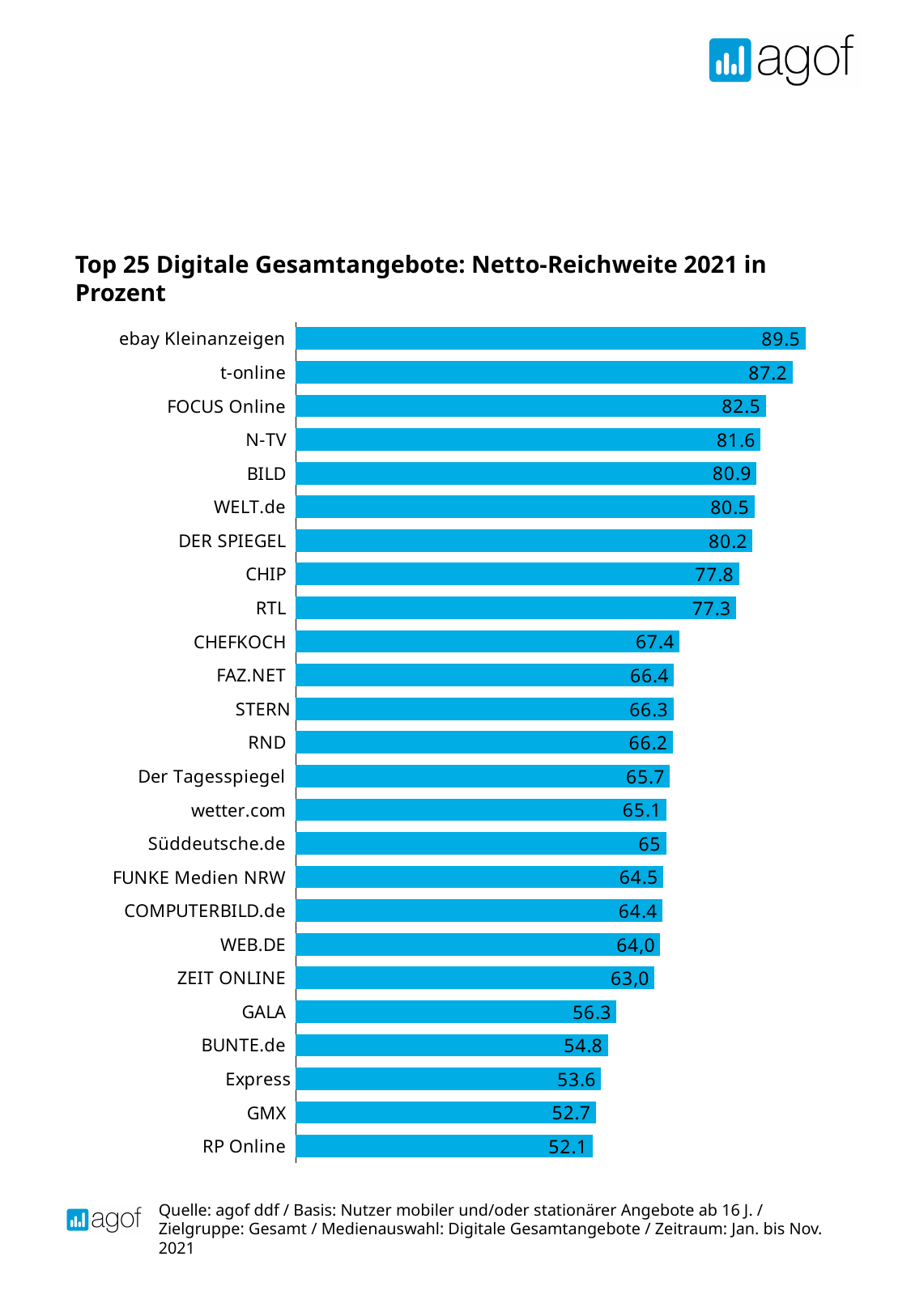
What is the difference between the values for RTL and CHEFKOCH? 9.9 What kind of chart is shown on the slide? Bar chart What is the value for ZEIT ONLINE? 63,0 Which is larger, the value for GALA or the value for BUNTE.de? GALA What is the difference between the values for ebay Kleinanzeigen and t-online? 2.3 What is the value for FOCUS Online? 82.5 Which category has the highest value? ebay Kleinanzeigen What is the value for Süddeutsche.de? 65 Which category has the lowest value? RP Online How many categories are shown in the chart? 25 What is the title of the chart? Top 25 Digitale Gesamtangebote: Netto-Reichweite 2021 in Prozent What is the value for CHEFKOCH? 67.4